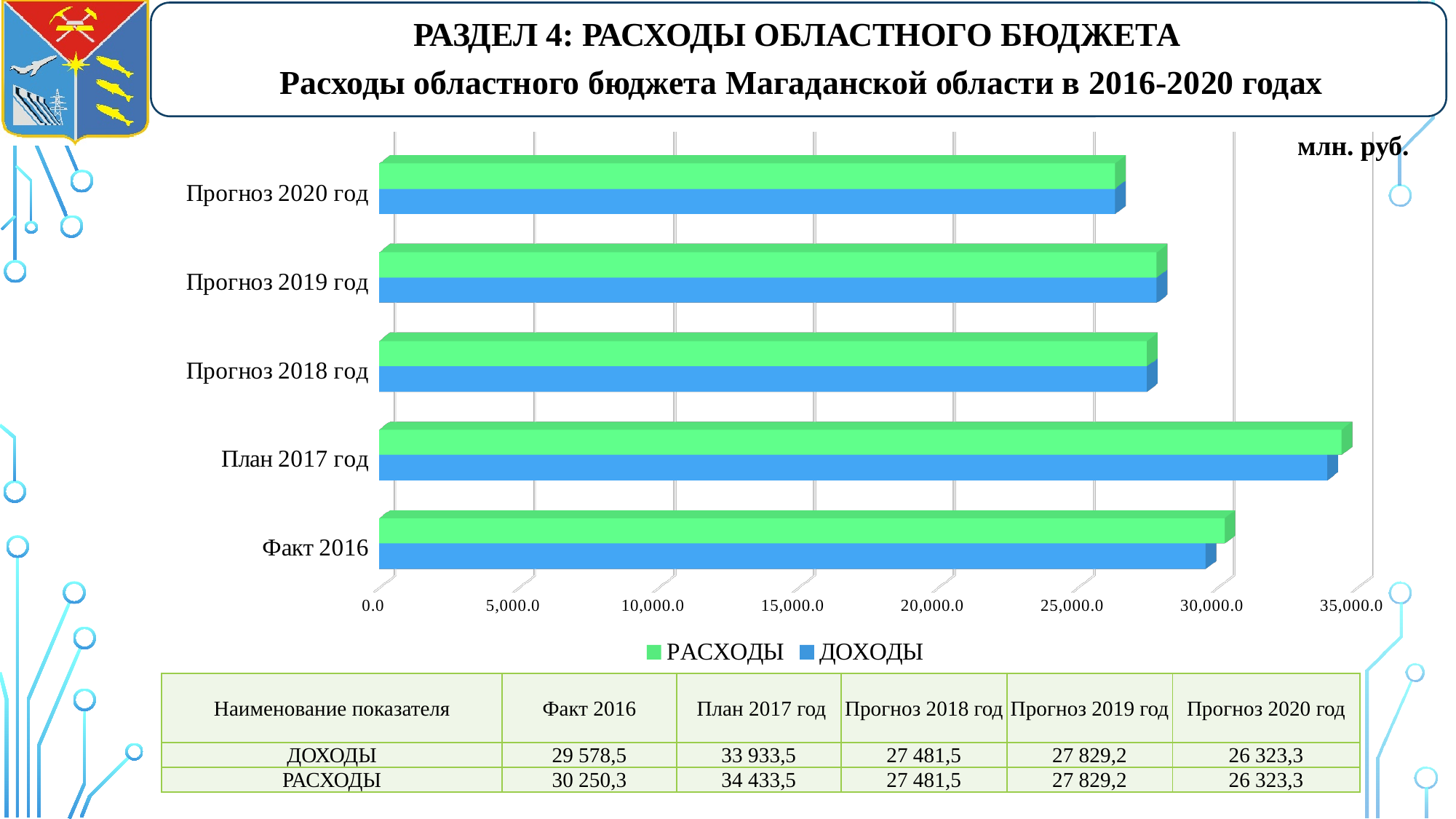
Which is larger, ДОХОДЫ for Прогноз 2019 год or ДОХОДЫ for Прогноз 2018 год? Прогноз 2019 год How many categories (years) are plotted on the chart? 5 What kind of chart is shown on the slide? bar chart Which category has the lowest value for ДОХОДЫ? Прогноз 2020 год How many series does the chart legend list? 2 What is the difference between РАСХОДЫ and ДОХОДЫ for Факт 2016? 671,8 Which category has the highest value for РАСХОДЫ? План 2017 год What is the value of РАСХОДЫ for План 2017 год? 34 433,5 What is the value of ДОХОДЫ for Факт 2016? 29 578,5 What is the difference between РАСХОДЫ and ДОХОДЫ for План 2017 год? 500,0 Is the value of ДОХОДЫ for План 2017 год greater or less than 30,000.0? greater What unit is indicated for the values on the chart? млн. руб.